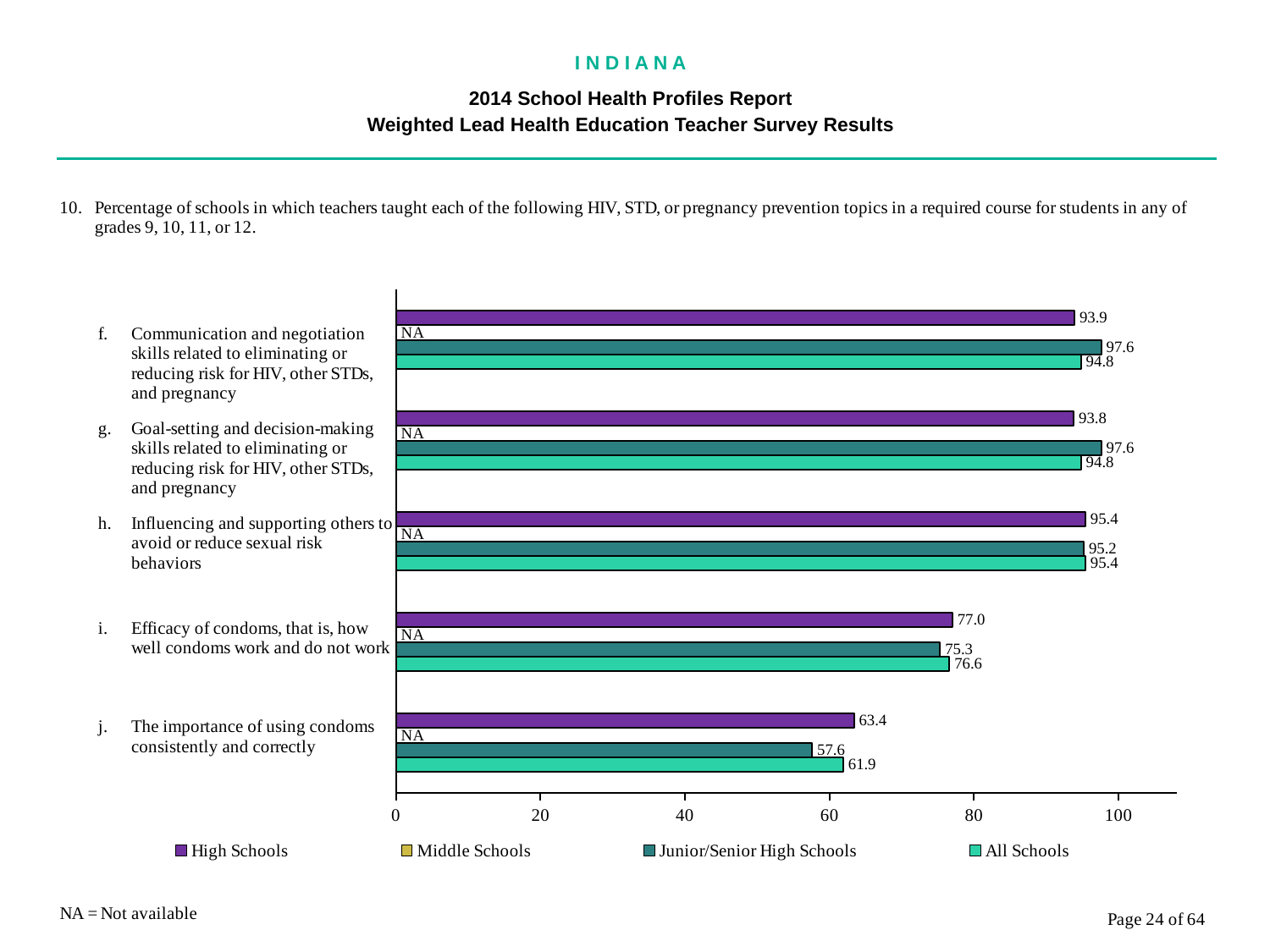
Is the All Schools value for "Efficacy of condoms, that is, how well condoms work and do not work" greater or less than 80? less What is the difference between the High Schools and Junior/Senior High Schools values for "The importance of using condoms consistently and correctly"? 5.8 What is the High Schools value for "The importance of using condoms consistently and correctly"? 63.4 What kind of chart is shown on the slide? Bar chart Which topic has the highest High Schools value? Influencing and supporting others to avoid or reduce sexual risk behaviors What is the All Schools value for "Influencing and supporting others to avoid or reduce sexual risk behaviors"? 95.4 How many topics (categories) are plotted on the chart? 5 Which topic has the lowest All Schools value? The importance of using condoms consistently and correctly How many series does the legend list? 4 What is the Junior/Senior High Schools value for "Efficacy of condoms, that is, how well condoms work and do not work"? 75.3 For "Communication and negotiation skills related to eliminating or reducing risk for HIV, other STDs, and pregnancy", which is larger: the High Schools value or the Junior/Senior High Schools value? Junior/Senior High Schools What value is shown for Middle Schools across all topics? NA